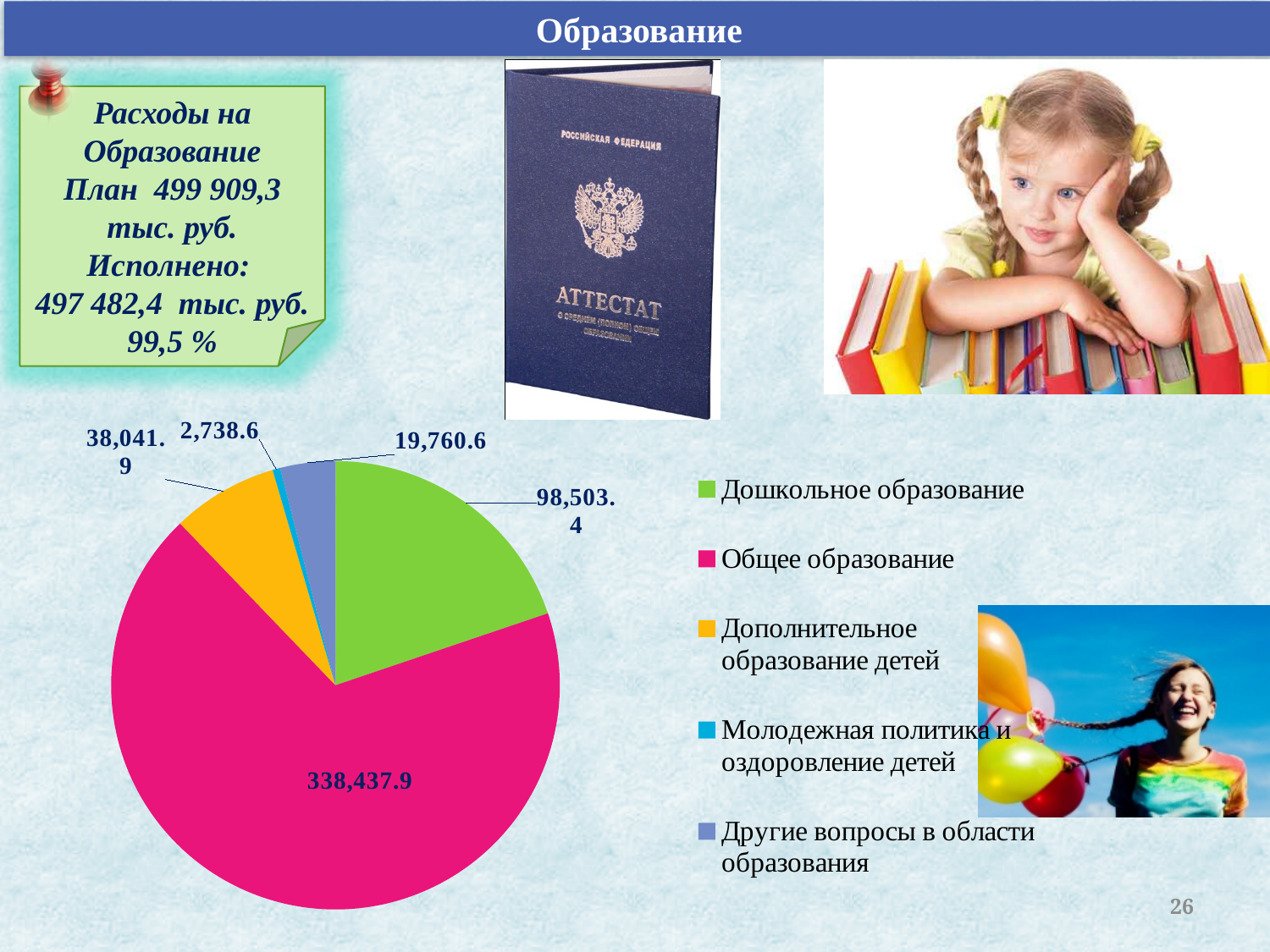
What is the value for Другие вопросы в области образования? 19,760.6 What is the difference between the values for Общее образование and Дошкольное образование? 239,934.5 What is the value for Общее образование? 338,437.9 What is the value for Молодежная политика и оздоровление детей? 2,738.6 What is the value for Дошкольное образование? 98,503.4 Which category has the largest slice of the pie? Общее образование Which category has the smallest slice of the pie? Молодежная политика и оздоровление детей How many categories does the legend list? 5 What colour is the slice for Дошкольное образование? green Which is larger: Дополнительное образование детей or Другие вопросы в области образования? Дополнительное образование детей What is the value for Дополнительное образование детей? 38,041.9 What type of chart is shown on the slide? pie chart